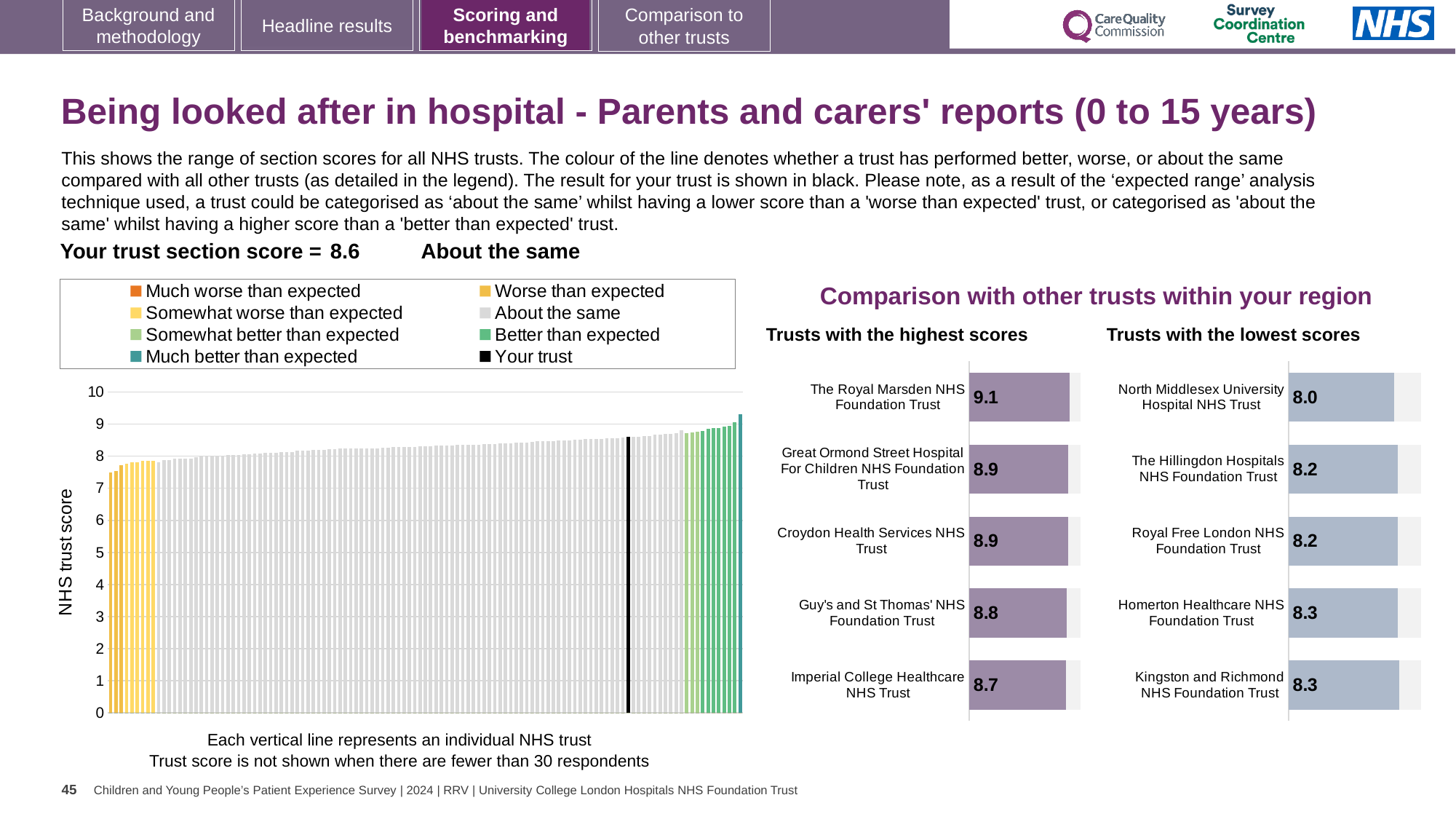
In the 'Trusts with the lowest scores' chart, what is the score for North Middlesex University Hospital NHS Trust? 8.0 How many entries does the legend of the large chart on the left list? 8 In the 'Trusts with the highest scores' chart, which trust has the highest score? The Royal Marsden NHS Foundation Trust How many trusts are shown in the 'Trusts with the lowest scores' chart? 5 In the 'Trusts with the lowest scores' chart, which trust has the lowest score? North Middlesex University Hospital NHS Trust In the 'Trusts with the lowest scores' chart, which has the larger score: The Hillingdon Hospitals NHS Foundation Trust or Homerton Healthcare NHS Foundation Trust? Homerton Healthcare NHS Foundation Trust In the 'Trusts with the highest scores' chart, what is the score for The Royal Marsden NHS Foundation Trust? 9.1 In the 'Trusts with the lowest scores' chart, what is the score for Homerton Healthcare NHS Foundation Trust? 8.3 What kind of chart is the large chart on the left showing all NHS trusts? Bar chart In the 'Trusts with the highest scores' chart, what is the score for Imperial College Healthcare NHS Trust? 8.7 In the large chart on the left showing all NHS trusts, is the value of the black bar for your trust greater or less than 8? greater In the 'Trusts with the highest scores' chart, what is the difference between the scores of The Royal Marsden NHS Foundation Trust and Imperial College Healthcare NHS Trust? 0.4